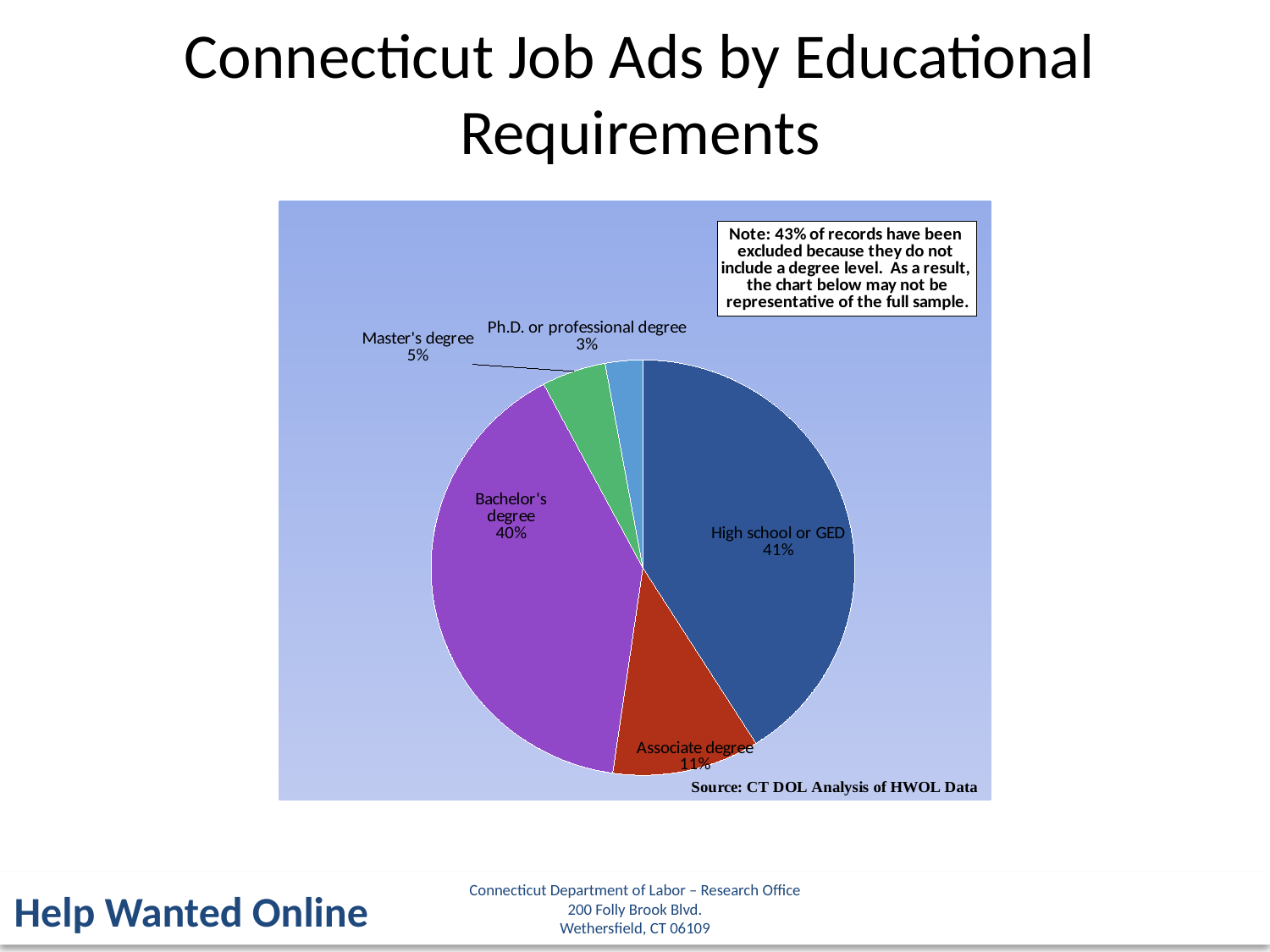
What share of job ads require a Ph.D. or professional degree? 3% What share of Connecticut job ads require a High school or GED? 41% Which educational requirement has the smallest slice of the pie? Ph.D. or professional degree What is the difference in percentage points between the Associate degree slice and the Master's degree slice? 6 What is the title of the chart on the slide? Connecticut Job Ads by Educational Requirements Which is larger, the Associate degree slice or the Master's degree slice? Associate degree What kind of chart is shown on the slide? pie chart What share of job ads require a Master's degree? 5% How many slices does the pie chart have? 5 What share of job ads require a Bachelor's degree? 40% According to the note on the chart, what percentage of records were excluded because they do not include a degree level? 43% What share of job ads require an Associate degree? 11%